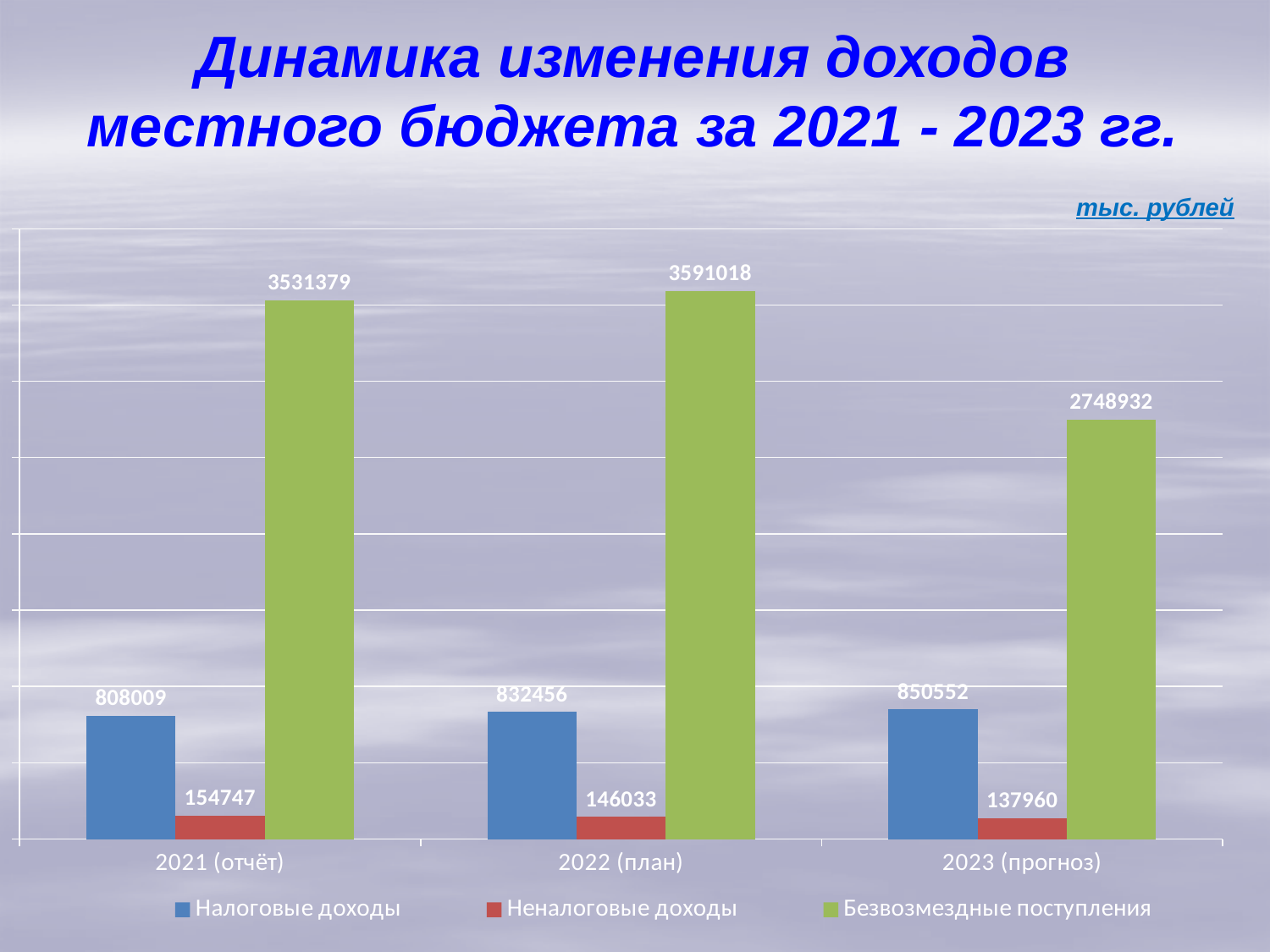
How many year categories are shown on the x axis? 3 What is the difference between Безвозмездные поступления in 2022 (план) and in 2021 (отчёт)? 59639 Do the values of Неналоговые доходы rise or fall from 2021 to 2023? Fall What is the value of Безвозмездные поступления for 2023 (прогноз)? 2748932 What is the value of Налоговые доходы for 2021 (отчёт)? 808009 What is the difference between Налоговые доходы in 2023 (прогноз) and in 2021 (отчёт)? 42543 In which year is Безвозмездные поступления the highest? 2022 (план) In which year is Неналоговые доходы the lowest? 2023 (прогноз) How many series does the legend list? 3 What kind of chart is shown on the slide? Bar chart Which is larger: Налоговые доходы in 2022 (план) or Налоговые доходы in 2023 (прогноз)? Налоговые доходы in 2023 (прогноз) What is the value of Неналоговые доходы for 2022 (план)? 146033